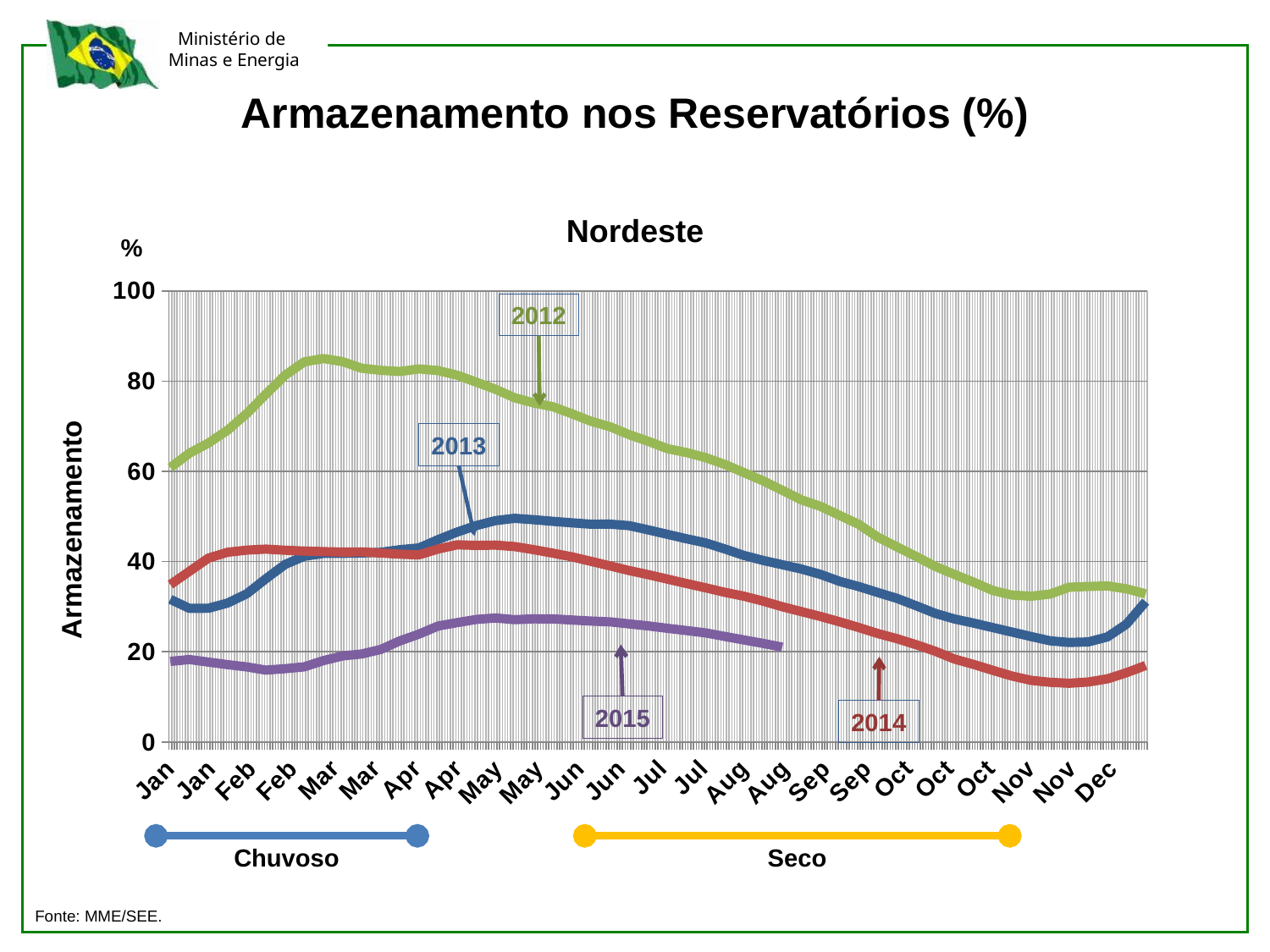
Does the 2012 line rise or fall from March to November? fall In June, which is larger: the value for 2012 or the value for 2015? 2012 Is the value for 2012 in early March greater or less than 80? greater Is the value for 2013 in May greater or less than 40? greater What is the title of the chart? Nordeste Which year's line is the lowest across the chart? 2015 Is the value for 2014 in December greater or less than 20? less How many data series (years) are plotted on the chart? 4 What is the label on the vertical axis of the chart? Armazenamento Which year's line is the highest across the chart? 2012 What kind of chart is shown on the slide? line chart